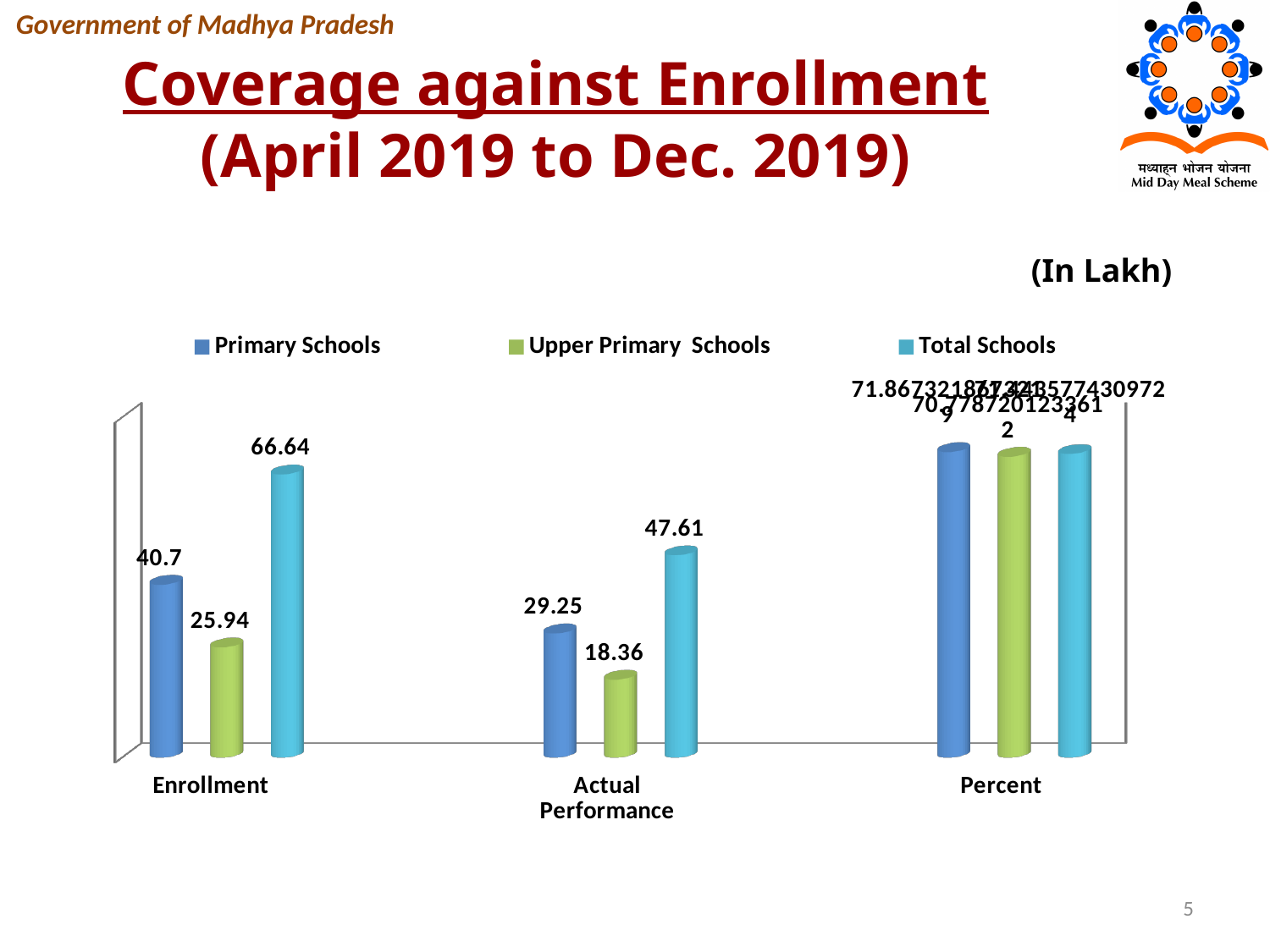
How many categories are shown on the x axis of the chart? 3 How many series does the chart legend list? 3 What is the value for Upper Primary Schools in the Enrollment category? 25.94 Which series has the highest value in the Enrollment category? Total Schools What is the value for Upper Primary Schools in the Actual Performance category? 18.36 What is the difference between the Primary Schools values for Enrollment and Actual Performance? 11.45 What kind of chart is shown on the slide? Bar chart What is the value for Total Schools in the Actual Performance category? 47.61 What is the value for Primary Schools in the Enrollment category? 40.7 Which series has the lowest value in the Actual Performance category? Upper Primary Schools Which is larger: the Primary Schools value for Enrollment or the Total Schools value for Actual Performance? Total Schools value for Actual Performance What is the difference between the Total Schools and Primary Schools values in the Enrollment category? 25.94